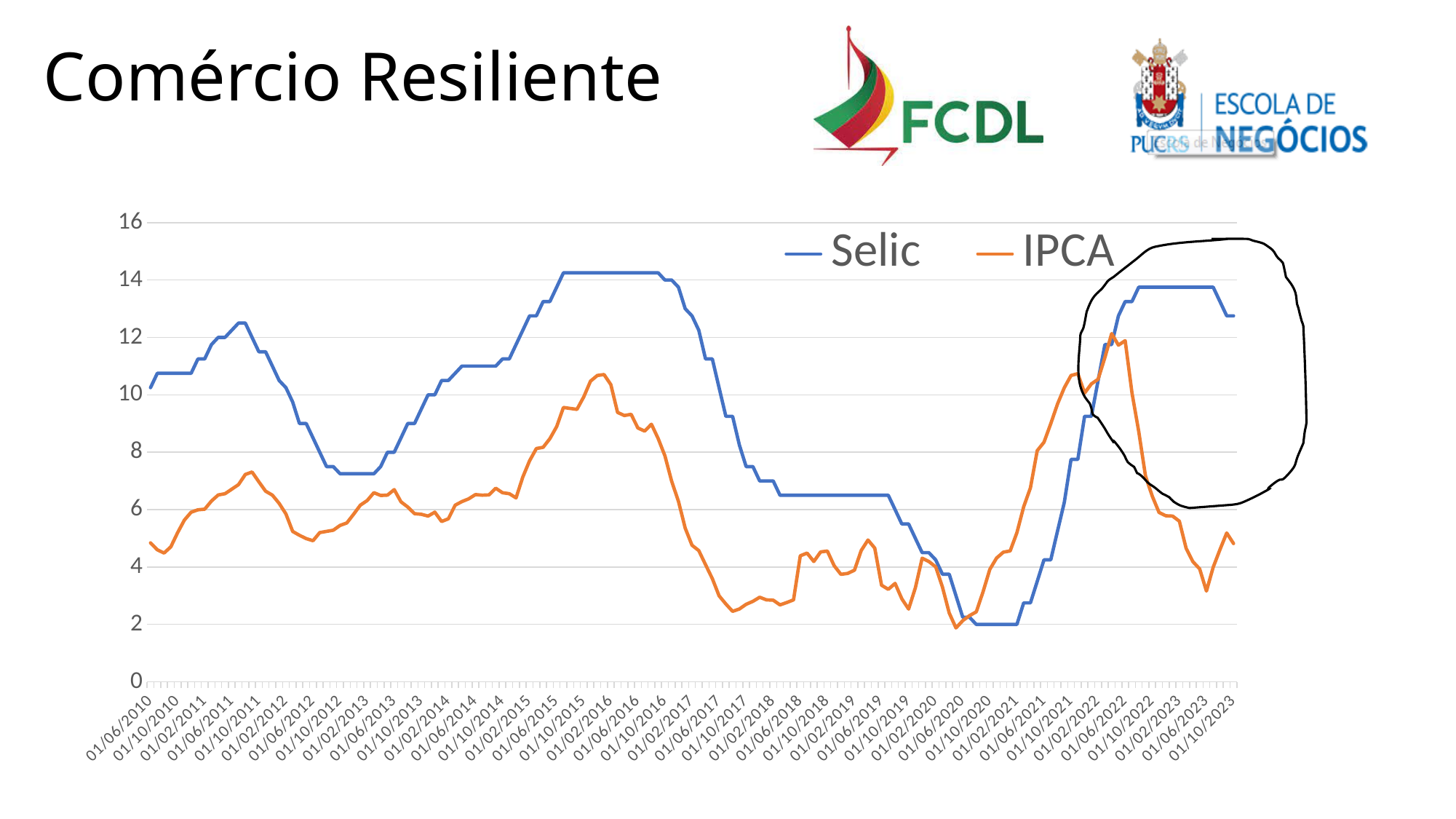
At 01/10/2015, which series has the higher value, Selic or IPCA? Selic Is the Selic value at 01/10/2015 greater or less than 12? greater How many series does the chart's legend list? 2 What kind of chart is shown on the slide? line chart Is the Selic value at 01/02/2013 greater or less than 8? less Is the IPCA value at 01/10/2017 greater or less than 4? less What are the two series named in the chart's legend? Selic and IPCA Which series is drawn in blue? Selic Does the Selic line rise or fall between 01/06/2016 and 01/02/2018? fall At 01/10/2021, which series has the higher value, Selic or IPCA? IPCA